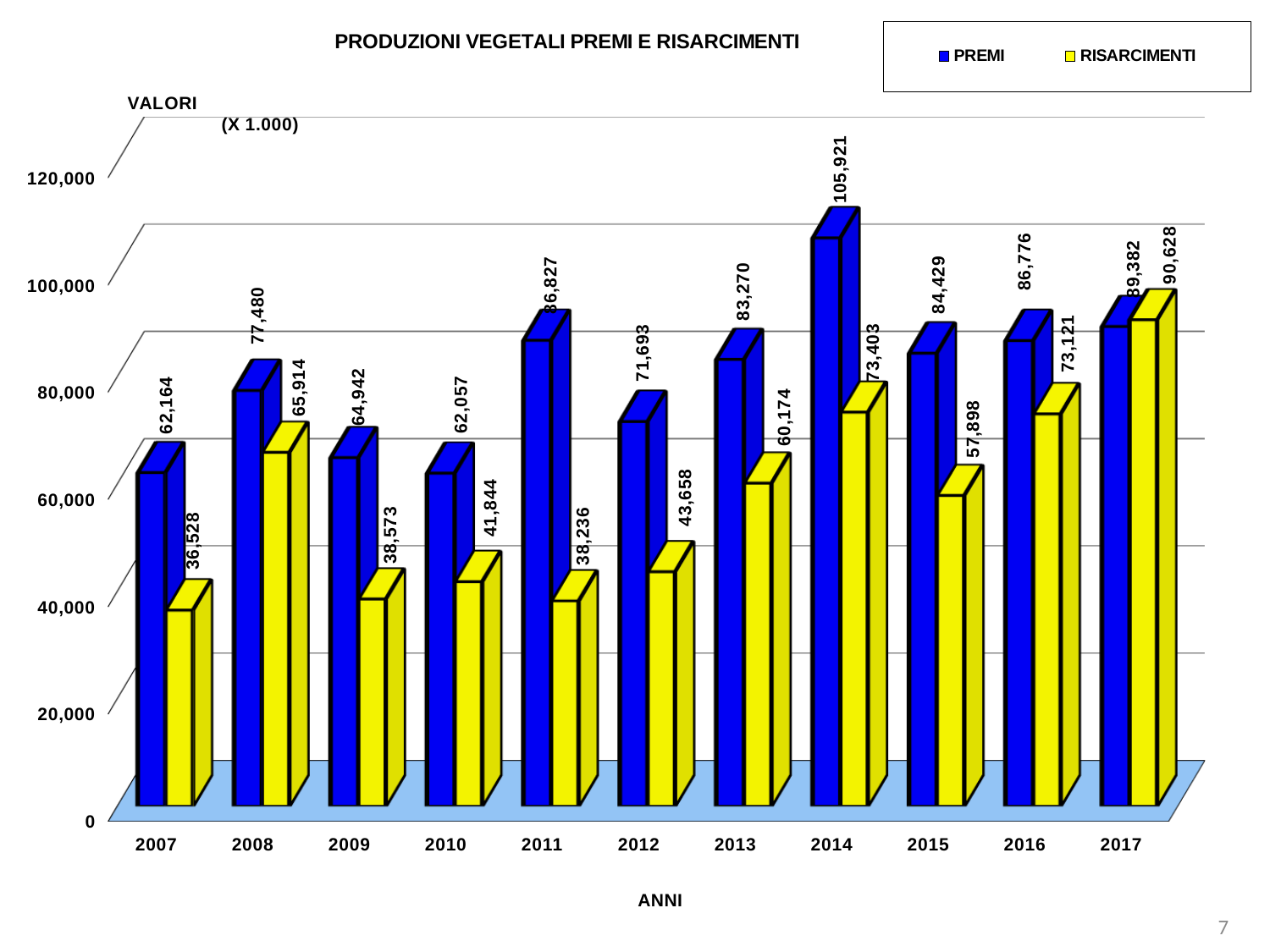
Which year has the lowest RISARCIMENTI value? 2007 Which year has the highest RISARCIMENTI value? 2017 How many years are shown on the x axis? 11 What is the difference between PREMI and RISARCIMENTI in 2007? 25,636 Which year has the highest PREMI value? 2014 In 2017, which is larger: PREMI or RISARCIMENTI? RISARCIMENTI How many series does the legend list? 2 What is the difference between PREMI and RISARCIMENTI in 2014? 32,518 What kind of chart is shown on the slide? Bar chart What is the PREMI value for 2014? 105,921 What is the PREMI value for 2011? 86,827 What is the RISARCIMENTI value for 2010? 41,844